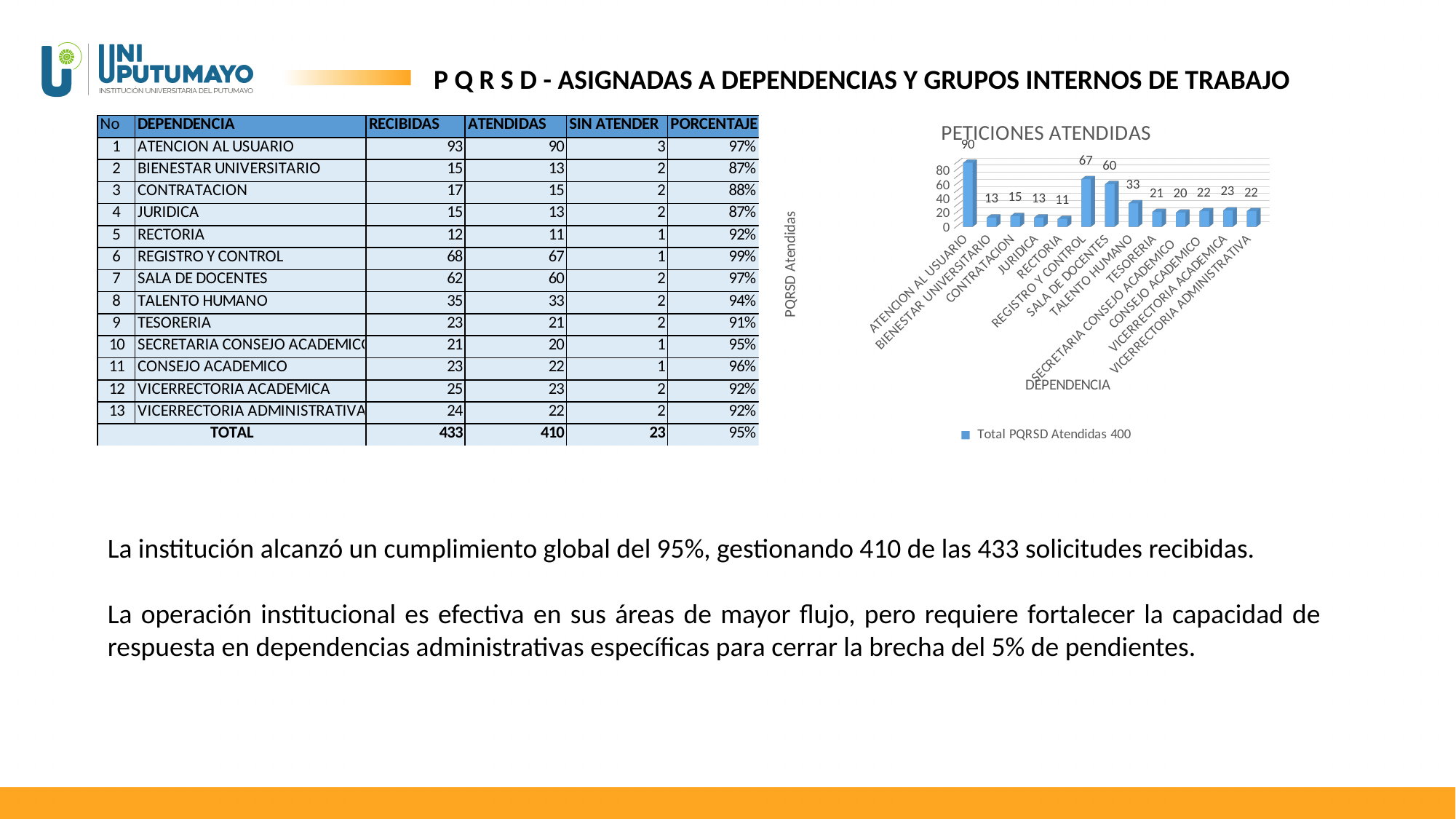
How many series does the legend of the PETICIONES ATENDIDAS chart list? 1 In the PETICIONES ATENDIDAS chart, which dependencia has the lowest value? RECTORIA What type of chart is shown under the title PETICIONES ATENDIDAS? Bar chart In the PETICIONES ATENDIDAS chart, what is the value for ATENCION AL USUARIO? 90 In the PETICIONES ATENDIDAS chart, which dependencia has the highest value? ATENCION AL USUARIO In the PETICIONES ATENDIDAS chart, what is the difference between the values for REGISTRO Y CONTROL and SALA DE DOCENTES? 7 In the PETICIONES ATENDIDAS chart, what is the value for REGISTRO Y CONTROL? 67 In the PETICIONES ATENDIDAS chart, is the value for SALA DE DOCENTES greater or less than 40? greater In the PETICIONES ATENDIDAS chart, which is larger: the value for TESORERIA or the value for VICERRECTORIA ACADEMICA? VICERRECTORIA ACADEMICA In the PETICIONES ATENDIDAS chart, what is the value for TALENTO HUMANO? 33 What is the legend entry shown in the PETICIONES ATENDIDAS chart? Total PQRSD Atendidas 400 How many dependencias (categories) are plotted in the PETICIONES ATENDIDAS chart? 13